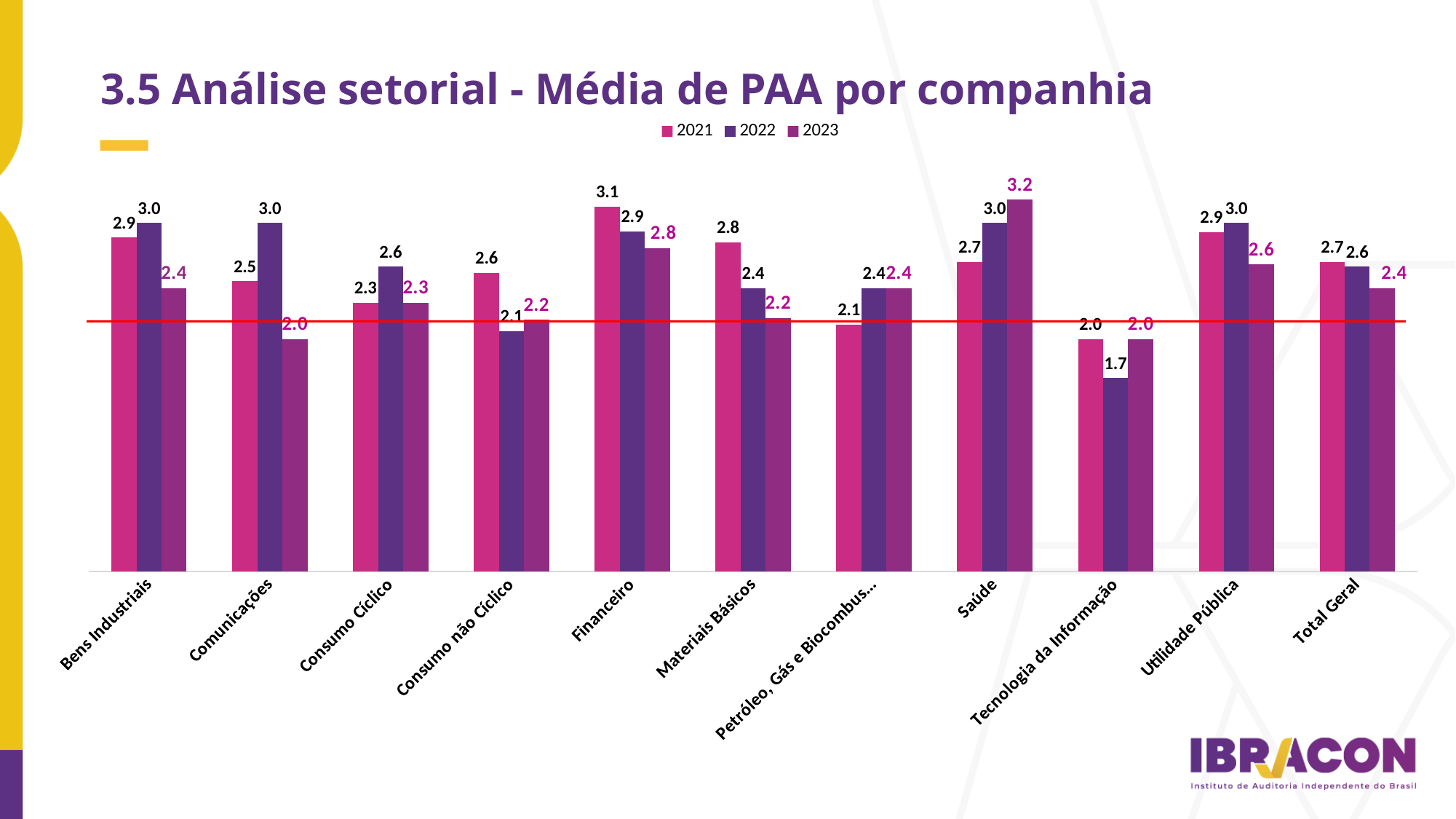
What is the difference between the 2021 and 2023 values for Financeiro? 0.3 Which category has the highest value in the 2023 series? Saúde What is the value for Tecnologia da Informação in 2022? 1.7 Do the values for Total Geral rise or fall from 2021 to 2023? Fall Which category has the highest value in the 2021 series? Financeiro What is the value for Consumo não Cíclico in 2021? 2.6 How many categories are shown on the x axis? 11 What is the value for Saúde in 2023? 3.2 How many series does the legend list? 3 Which category has the lowest value in the 2022 series? Tecnologia da Informação What kind of chart is shown on the slide? Bar chart For Comunicações, which year has the larger value, 2022 or 2023? 2022